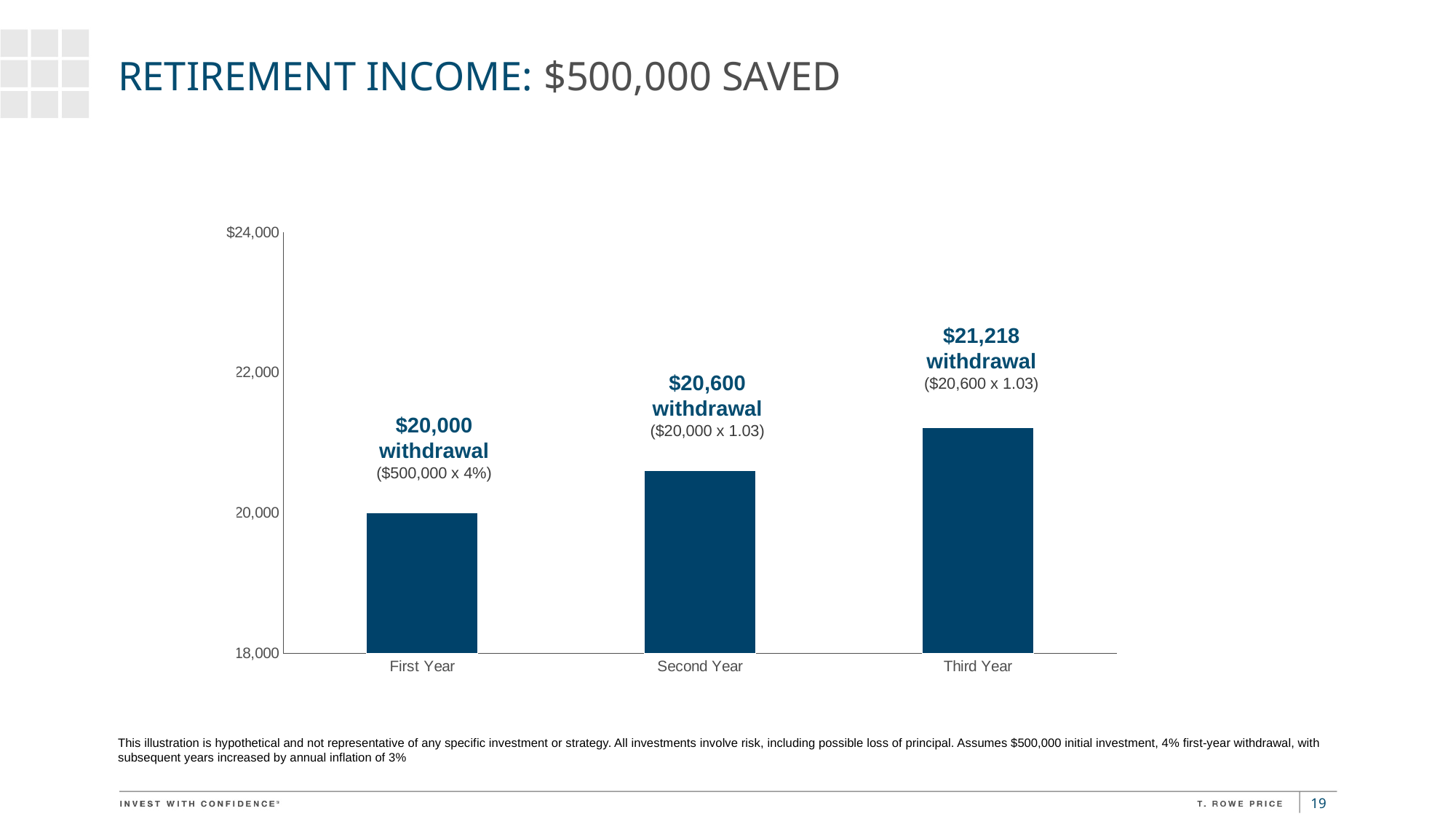
What kind of chart is shown on the slide? bar chart What is the withdrawal amount for Third Year? $21,218 Do the withdrawal values rise or fall from First Year to Third Year? rise Which is larger, the Second Year withdrawal or the Third Year withdrawal? Third Year Which year has the lowest withdrawal? First Year What is the withdrawal amount for Second Year? $20,600 Which year has the highest withdrawal? Third Year What is the difference between the Third Year and First Year withdrawals? $1,218 What is the withdrawal amount for First Year? $20,000 Is the value for Third Year greater or less than 22,000? less How many years are shown on the chart? 3 What is the difference between the Second Year and First Year withdrawals? $600